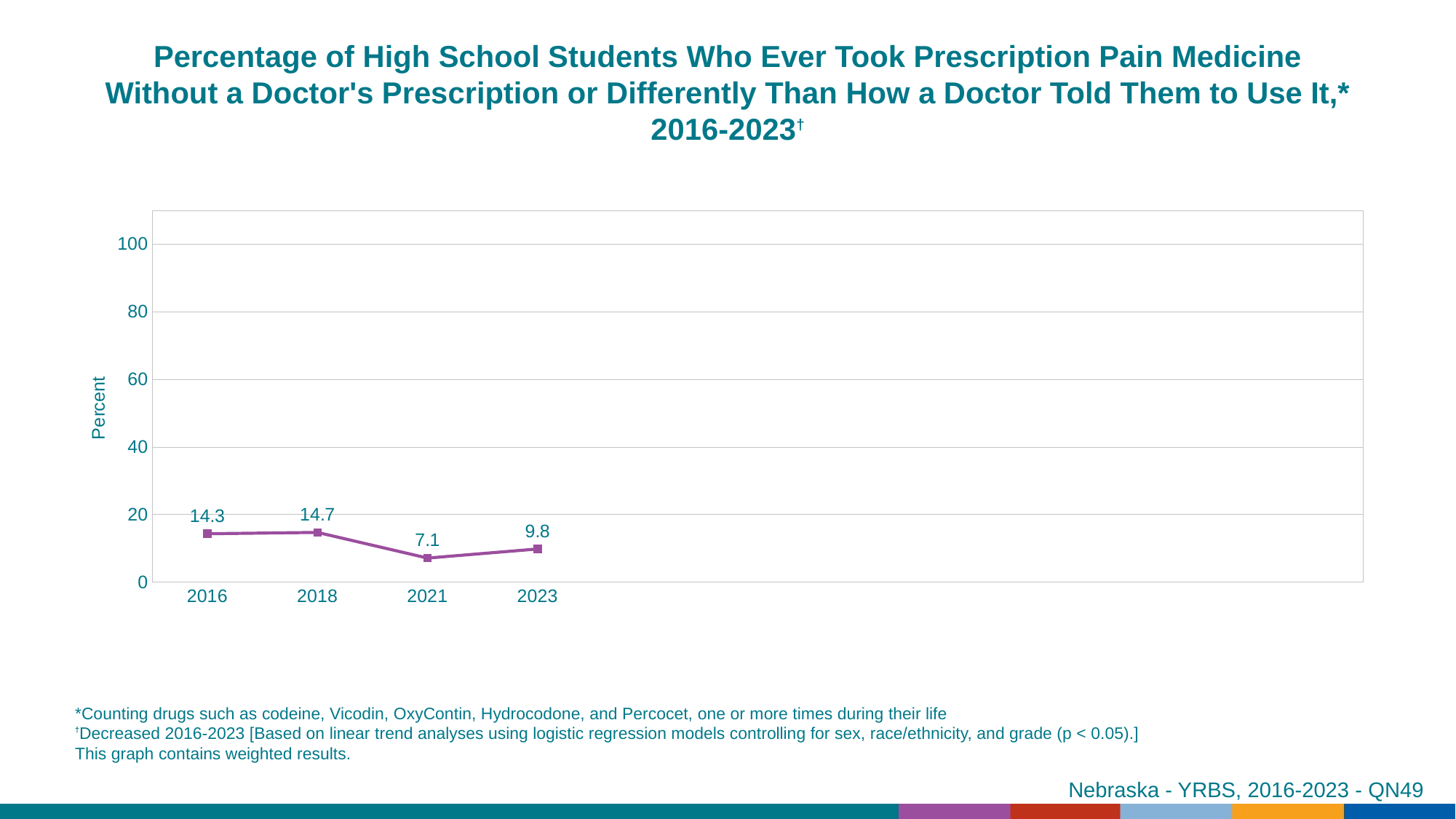
Which year has the lowest value? 2021 What is the difference between the values for 2018 and 2021? 7.6 What is the label on the y axis? Percent What is the value for 2016? 14.3 What kind of chart is shown on the slide? line chart Does the value rise or fall from 2021 to 2023? rise What is the value for 2023? 9.8 What is the value for 2021? 7.1 Which year has the highest value? 2018 How many years are plotted on the chart? 4 Which is larger, the value for 2016 or the value for 2023? 2016 Is the value for 2018 greater or less than 20? less